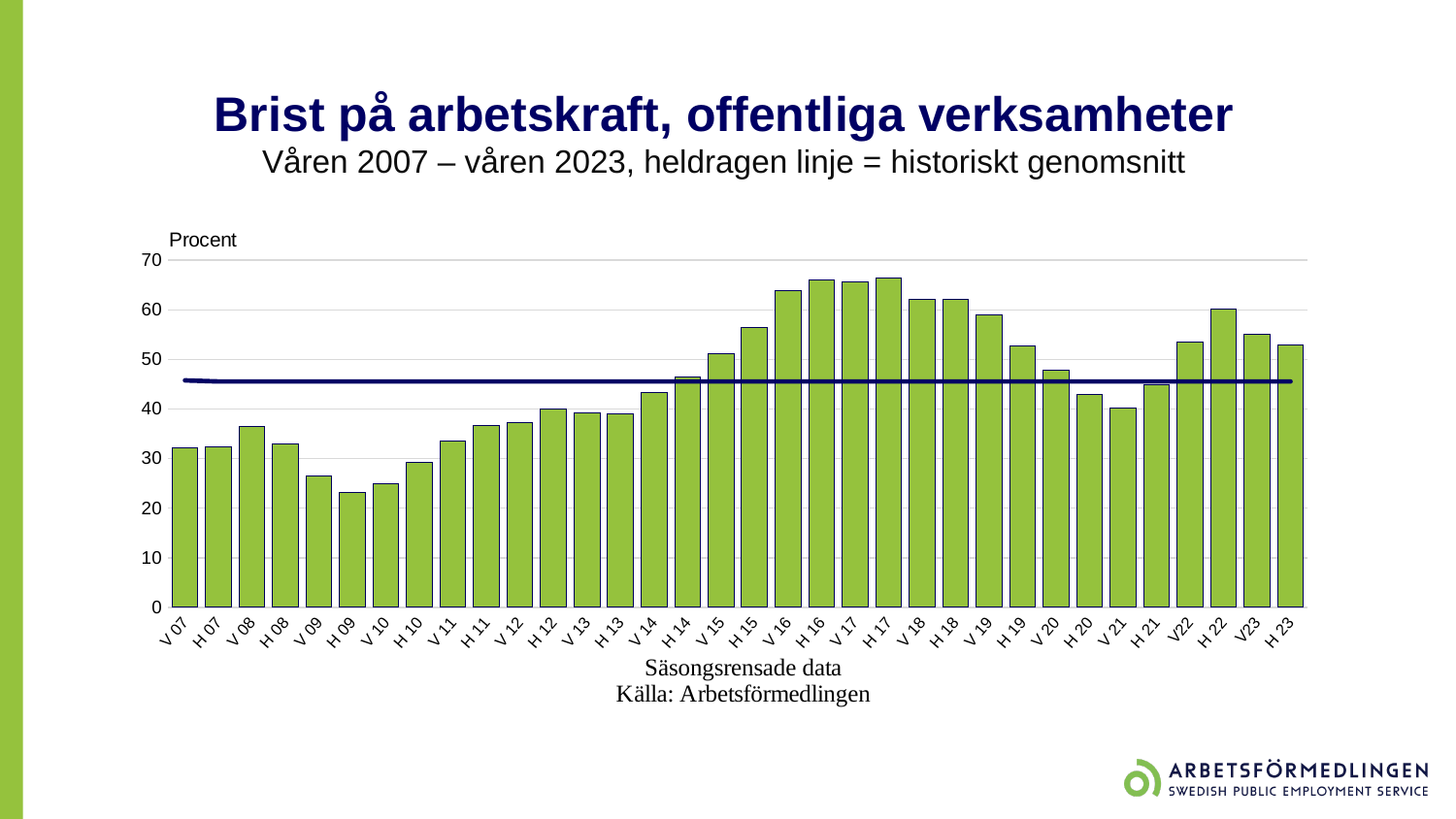
Which period has the lowest value in the chart? H 09 Is the value for V 12 greater or less than 40? less Is the value for V 16 greater or less than 60? greater Is the value for V 07 greater or less than 30? greater What kind of chart is shown on the slide? Bar chart Which is larger, the value for V 22 or the value for H 22? H 22 Do the values generally rise or fall from H 09 to H 16? Rise Which is larger, the value for H 09 or the value for H 19? H 19 What does the solid horizontal line in the chart represent, according to the subtitle? Historiskt genomsnitt (historical average) How many bars (half-year periods) are plotted in the chart? 34